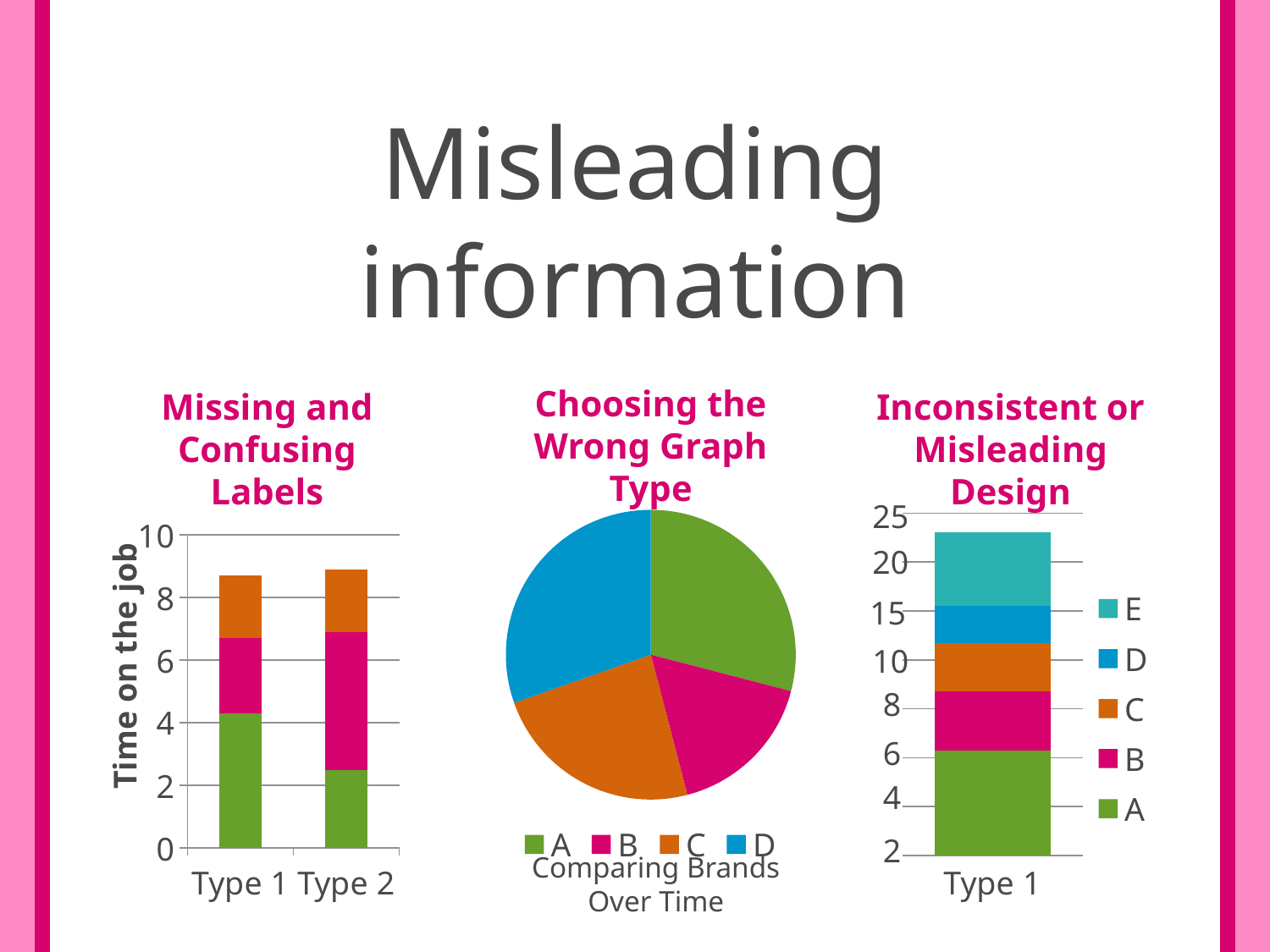
How many categories are shown on the x axis of the 'Inconsistent or Misleading Design' chart? 1 In the 'Missing and Confusing Labels' chart, is the total height of the Type 1 bar greater or less than 6? greater How many series does the legend of the 'Choosing the Wrong Graph Type' chart list? 4 What kind of chart is the 'Inconsistent or Misleading Design' chart? bar chart How many categories are shown on the x axis of the 'Missing and Confusing Labels' chart? 2 What kind of chart is the 'Missing and Confusing Labels' chart? bar chart In the 'Missing and Confusing Labels' chart, which bar has the larger green segment, Type 1 or Type 2? Type 1 In the 'Missing and Confusing Labels' chart, is the green segment of the Type 2 bar greater or less than 4? less What kind of chart is the 'Choosing the Wrong Graph Type' chart? pie chart How many series does the legend of the 'Inconsistent or Misleading Design' chart list? 5 In the 'Choosing the Wrong Graph Type' pie chart, which slice is the smallest? B What is the y-axis title of the 'Missing and Confusing Labels' chart? Time on the job